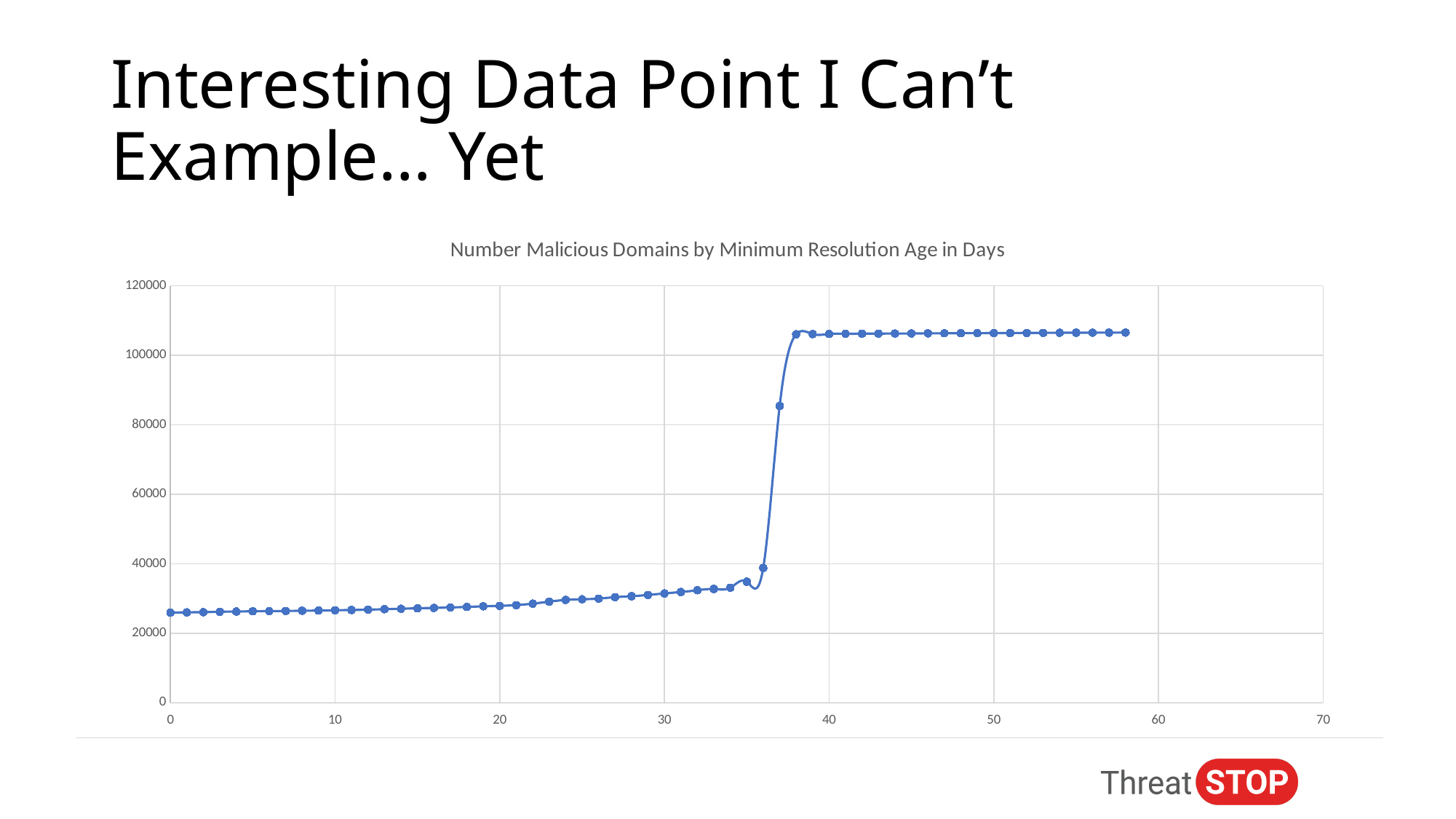
What kind of chart is shown on the slide? line chart Is the value at a minimum resolution age of 10 days greater or less than 20000? greater Is the value at a minimum resolution age of 50 days greater or less than 100000? greater Is the value at a minimum resolution age of 45 days greater or less than 120000? less What colour is the plotted line in the chart? blue Which is larger: the value at 30 days or the value at 55 days? 55 days Which is larger: the value at 10 days or the value at 40 days? 40 days What is the title of the chart? Number Malicious Domains by Minimum Resolution Age in Days Do the values generally rise or fall as the minimum resolution age increases along the x axis? rise